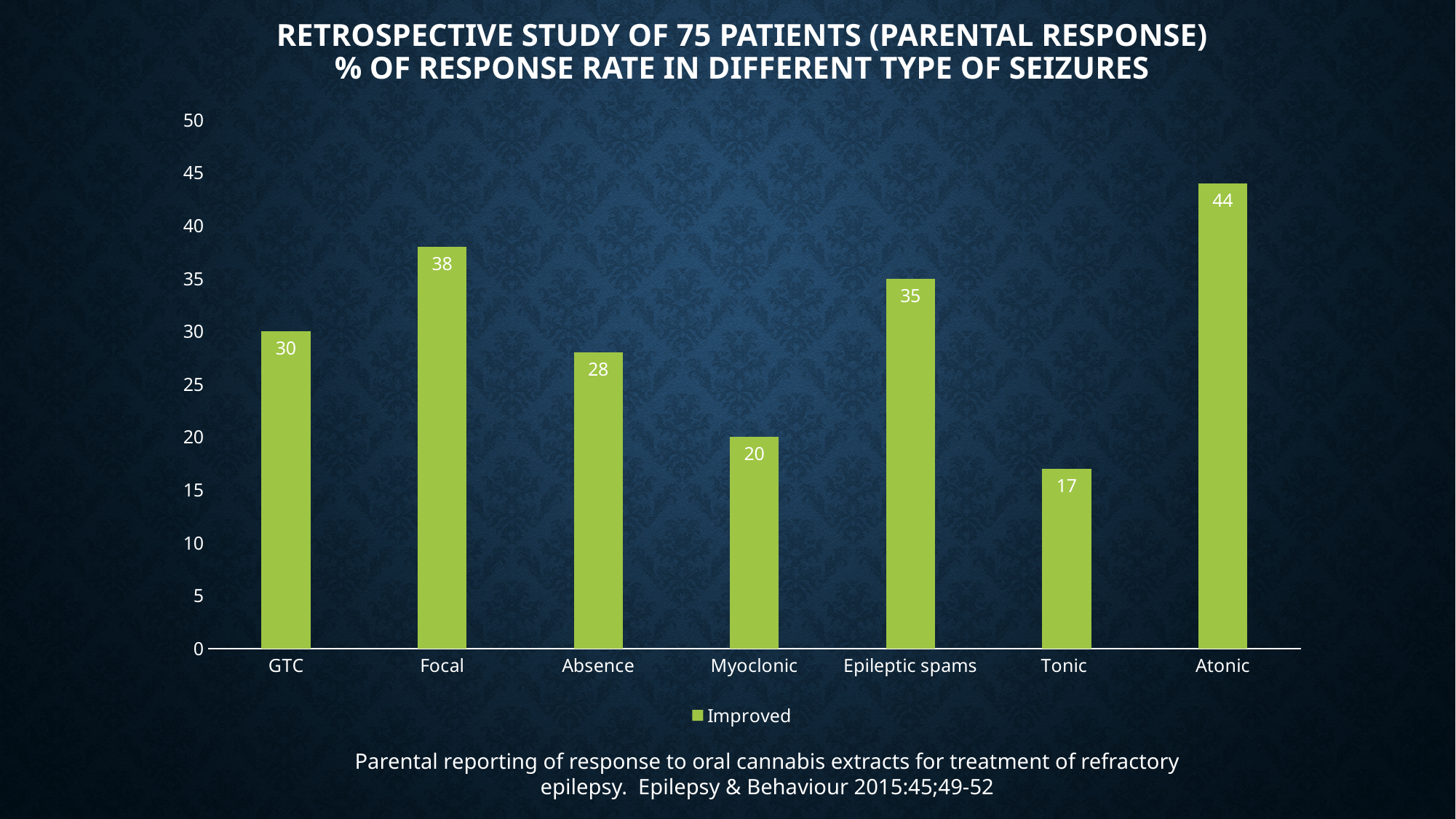
How many seizure types are shown on the x axis? 7 What is the value for Epileptic spams? 35 Which seizure type has the lowest response rate? Tonic What is the value for Focal? 38 What is the value for Tonic? 17 What is the name of the series in the legend? Improved Which is larger, the value for GTC or the value for Absence? GTC Is the value for Focal greater or less than 35? greater What kind of chart is shown on the slide? Bar chart Which seizure type has the highest response rate? Atonic How many series does the legend list? 1 What is the difference between the values for Atonic and Myoclonic? 24